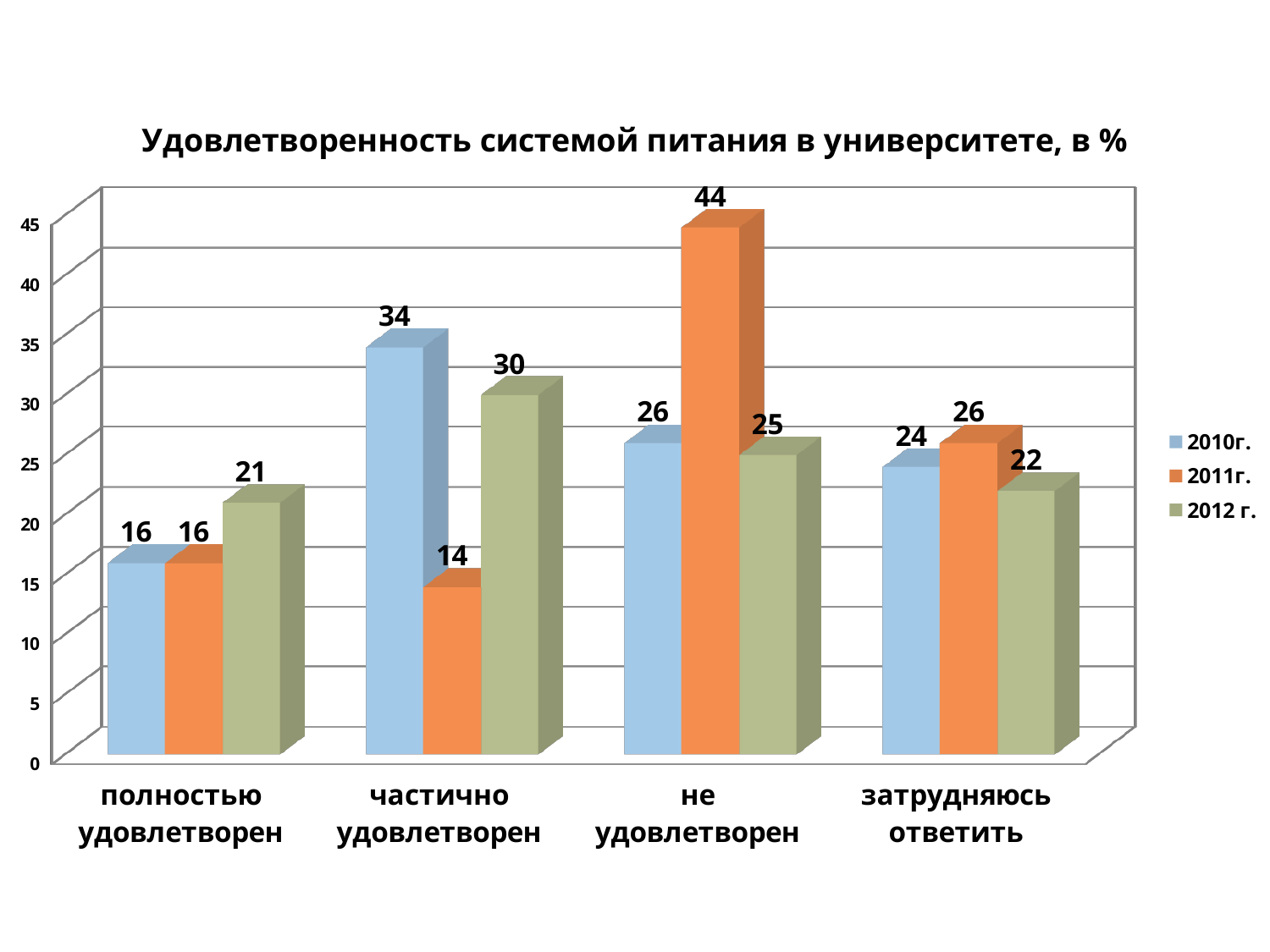
What is the difference between the 2010г. and 2011г. values in the 'частично удовлетворен' category? 20 Which category has the lowest value for the 2010г. series? полностью удовлетворен What is the title of the chart? Удовлетворенность системой питания в университете, в % What is the value for 2011г. in the 'не удовлетворен' category? 44 How many categories are shown on the x axis? 4 Which category has the highest value for the 2011г. series? не удовлетворен What kind of chart is shown on the slide? bar chart What is the value for 2012 г. in the 'частично удовлетворен' category? 30 Which is larger: the 2012 г. value for 'полностью удовлетворен' or the 2012 г. value for 'затрудняюсь ответить'? затрудняюсь ответить What is the value for 2010г. in the 'затрудняюсь ответить' category? 24 Is the 2011г. value for 'не удовлетворен' greater or less than 40? greater How many series does the legend list? 3